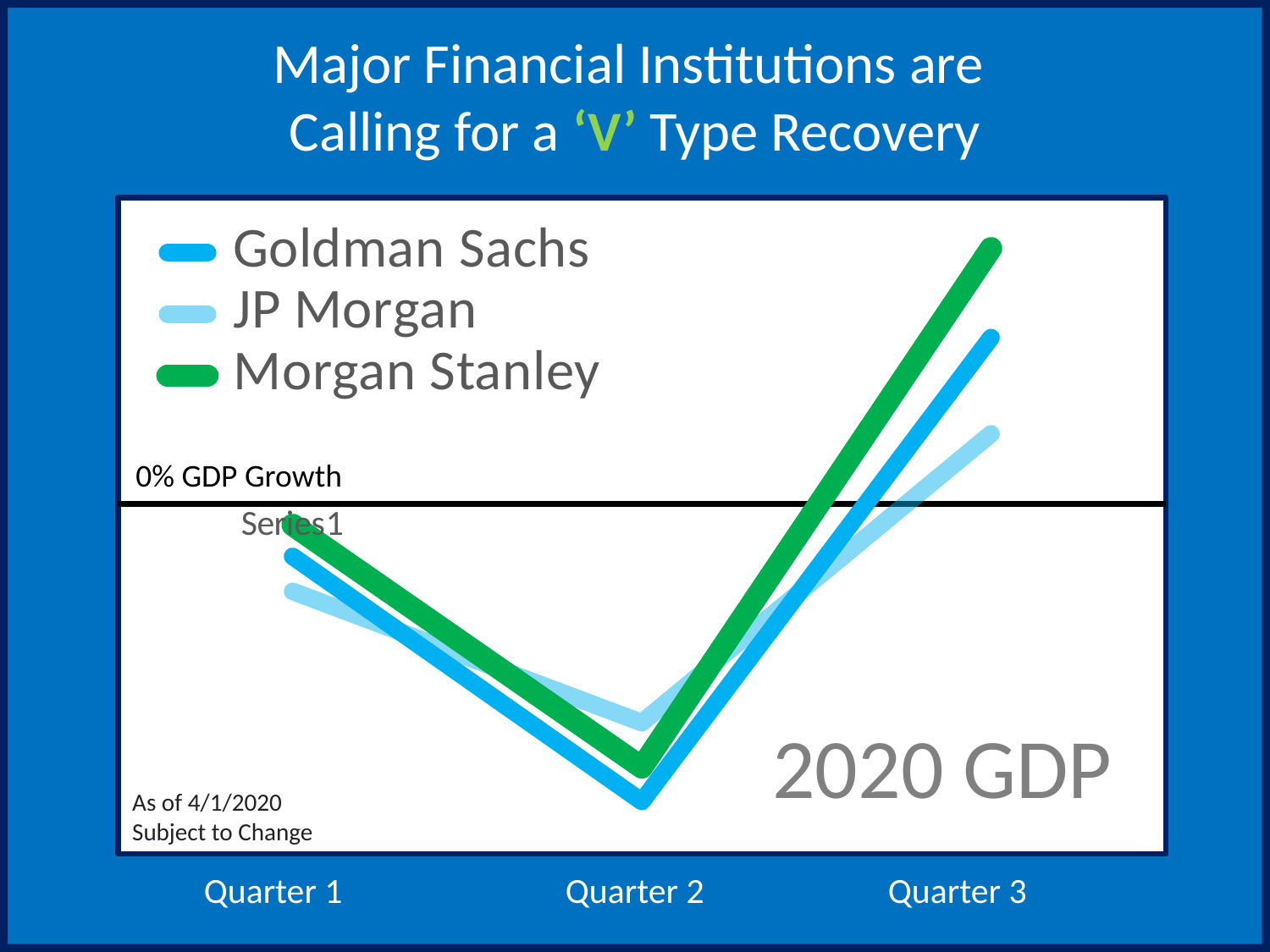
What label is printed on the horizontal reference line in the chart? 0% GDP Growth Do the lines rise or fall from Quarter 2 to Quarter 3? rise Which institution's line is highest at Quarter 2? JP Morgan How many quarters are shown along the x axis of the chart? 3 What kind of chart is shown on the slide? line chart Is the Goldman Sachs value for Quarter 3 greater or less than 0% GDP growth? greater Is the Morgan Stanley value for Quarter 2 greater or less than 0% GDP growth? less How many series does the chart legend list? 3 Which institution's line is lowest at Quarter 2? Goldman Sachs Which institution's line is lowest at Quarter 3? JP Morgan Which institution's line is highest at Quarter 3? Morgan Stanley At Quarter 3, which is larger: the Goldman Sachs value or the JP Morgan value? Goldman Sachs